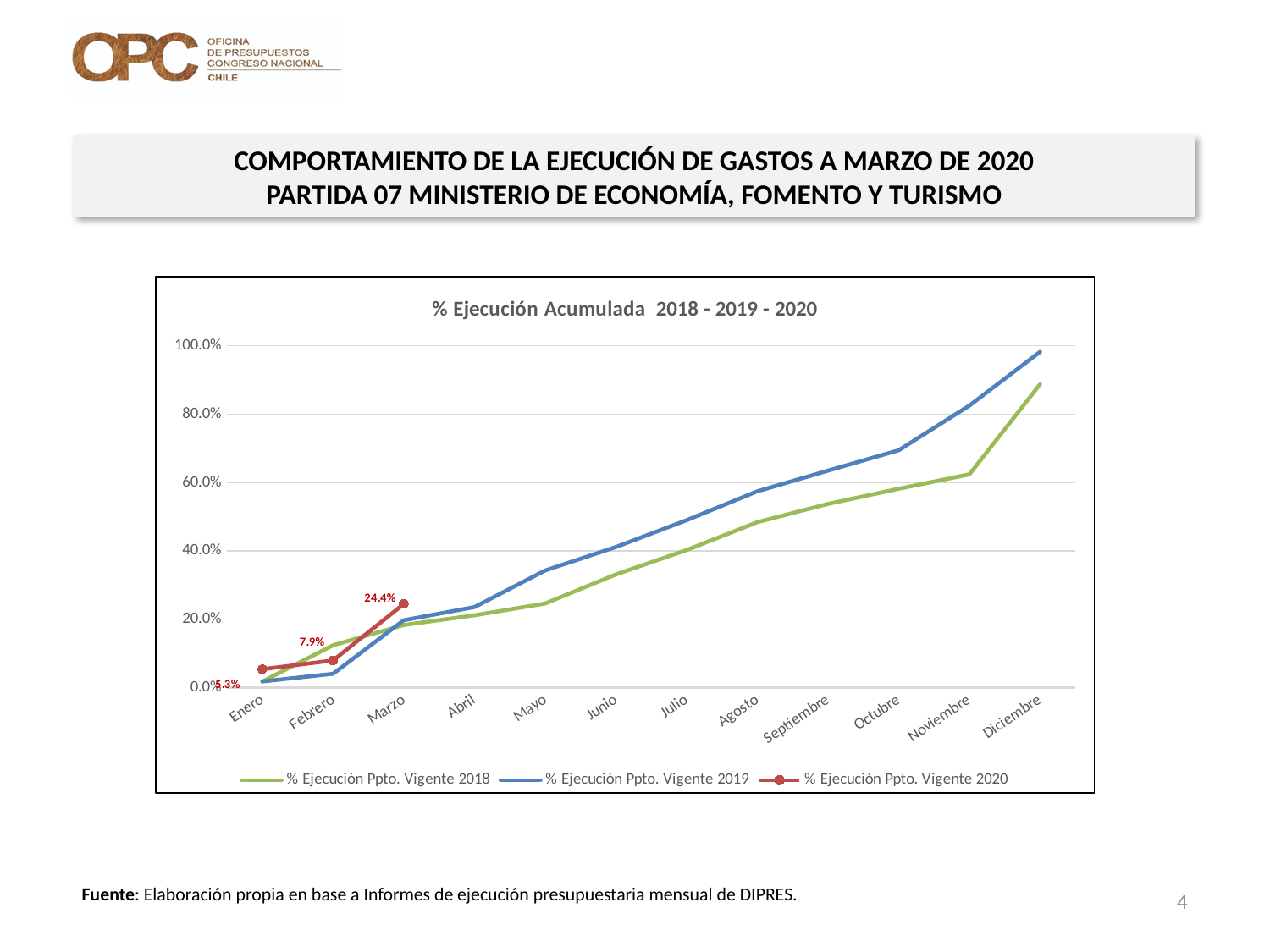
Which month has the highest value in the % Ejecución Ppto. Vigente 2020 series? Marzo What kind of chart is shown on the slide? Line chart What is the value for Enero in the % Ejecución Ppto. Vigente 2020 series? 5.3% What is the value for Febrero in the % Ejecución Ppto. Vigente 2020 series? 7.9% What is the value for Marzo in the % Ejecución Ppto. Vigente 2020 series? 24.4% How many series does the legend list? 3 Does the % Ejecución Ppto. Vigente 2019 series rise or fall from Enero to Diciembre? Rise What is the difference between the Marzo and Febrero values of the % Ejecución Ppto. Vigente 2020 series? 16.5% How many months are shown on the x axis? 12 Which series has the larger value in Diciembre, % Ejecución Ppto. Vigente 2018 or % Ejecución Ppto. Vigente 2019? % Ejecución Ppto. Vigente 2019 What is the difference between the Febrero and Enero values of the % Ejecución Ppto. Vigente 2020 series? 2.6% Is the Diciembre value for % Ejecución Ppto. Vigente 2019 greater or less than 80.0%? greater